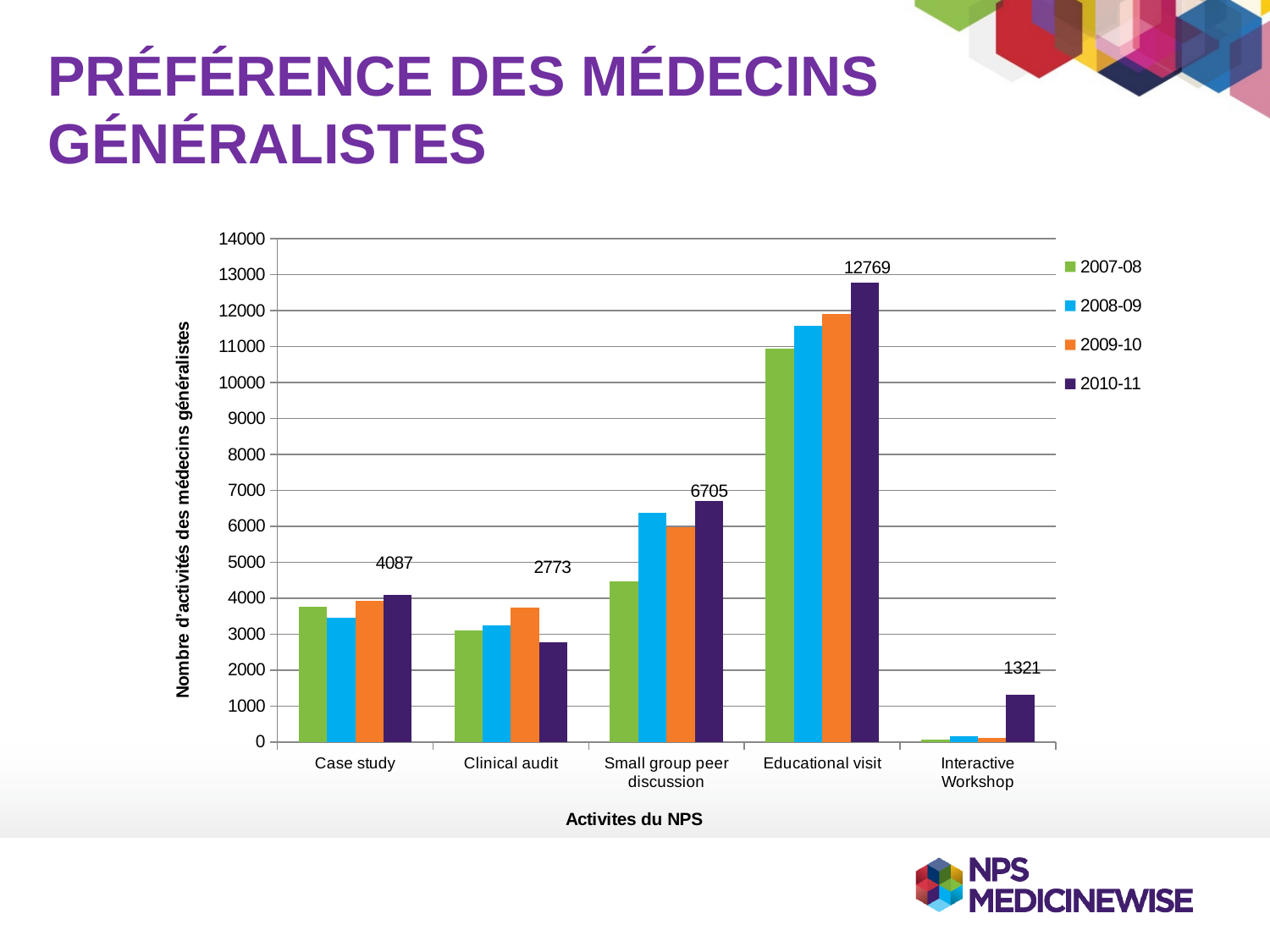
How many series does the legend list? 4 Is the value for Case study in the 2008-09 series greater or less than 4000? less Which category has the highest value in the 2010-11 series? Educational visit What is the value for Case study in the 2010-11 series? 4087 Which category has the lowest value in the 2010-11 series? Interactive Workshop What kind of chart is shown on the slide? bar chart Is the value for Educational visit in the 2007-08 series greater or less than 10000? greater In the 2010-11 series, which is larger: Case study or Clinical audit? Case study What is the value for Educational visit in the 2010-11 series? 12769 How many categories are shown on the x axis? 5 What is the value for Interactive Workshop in the 2010-11 series? 1321 What is the difference between the 2010-11 values for Educational visit and Small group peer discussion? 6064